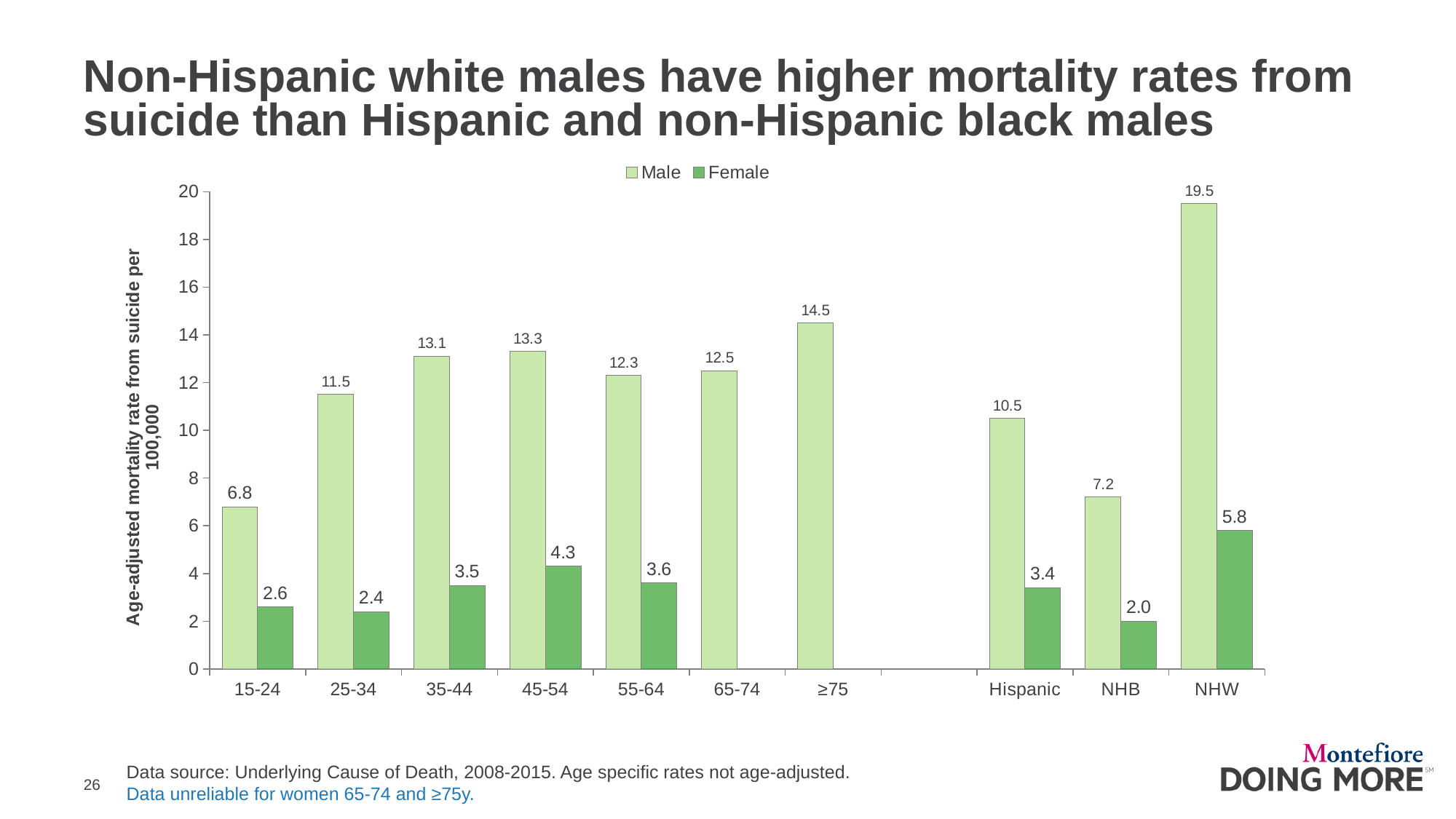
Which category has the lowest Female value? NHB What is the Female value for the 45-54 age group? 4.3 What is the Male value for the Hispanic category? 10.5 How many series does the legend list? 2 Which category has the highest Male value? NHW What kind of chart is shown on the slide? Bar chart What is the difference between the Male values for NHW and NHB? 12.3 What is the Male value for the NHW category? 19.5 Which is larger, the Male value for 35-44 or the Male value for 45-54? 45-54 What is the y-axis label of the chart? Age-adjusted mortality rate from suicide per 100,000 What is the difference between the Male and Female values for NHW? 13.7 How many categories are shown on the x axis? 10